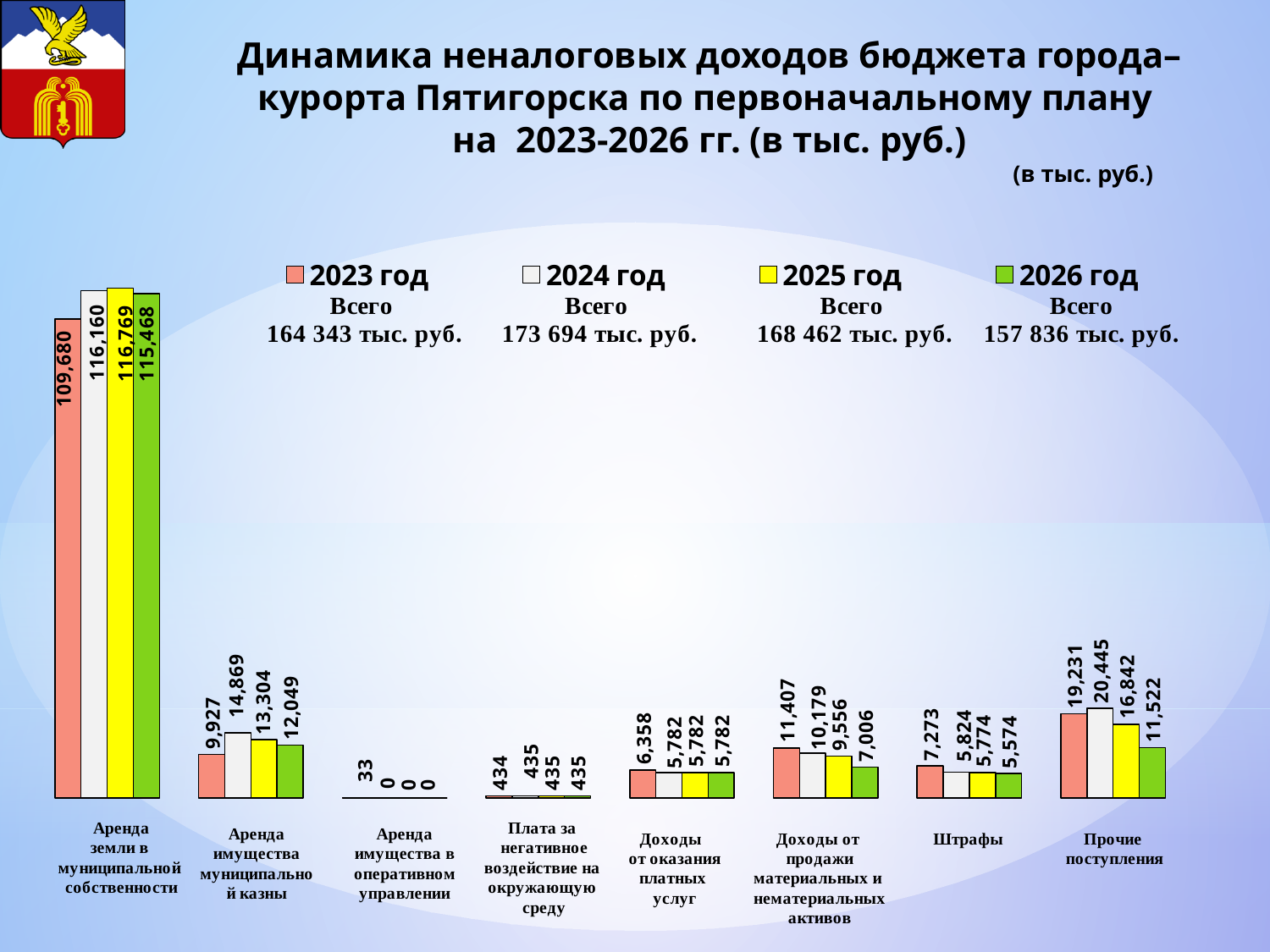
What kind of chart is shown on the slide? Bar chart Which category has the highest value for 2025 год? Аренда земли в муниципальной собственности What is the value for 2026 год in the category Прочие поступления? 11,522 Which category has the lowest value for 2023 год? Аренда имущества в оперативном управлении What is the value for 2023 год in the category Аренда земли в муниципальной собственности? 109,680 Do the values for Прочие поступления rise or fall from 2024 год to 2026 год? Fall What is the difference between the 2024 год and 2023 год values in the category Штрафы? 1,449 Which is larger in the category Доходы от продажи материальных и нематериальных активов: the value for 2023 год or for 2026 год? 2023 год What is the value for 2024 год in the category Аренда имущества муниципальной казны? 14,869 How many categories are shown on the x axis of the chart? 8 How many series does the chart legend list? 4 What total (Всего) is shown for 2024 год? 173 694 тыс. руб.